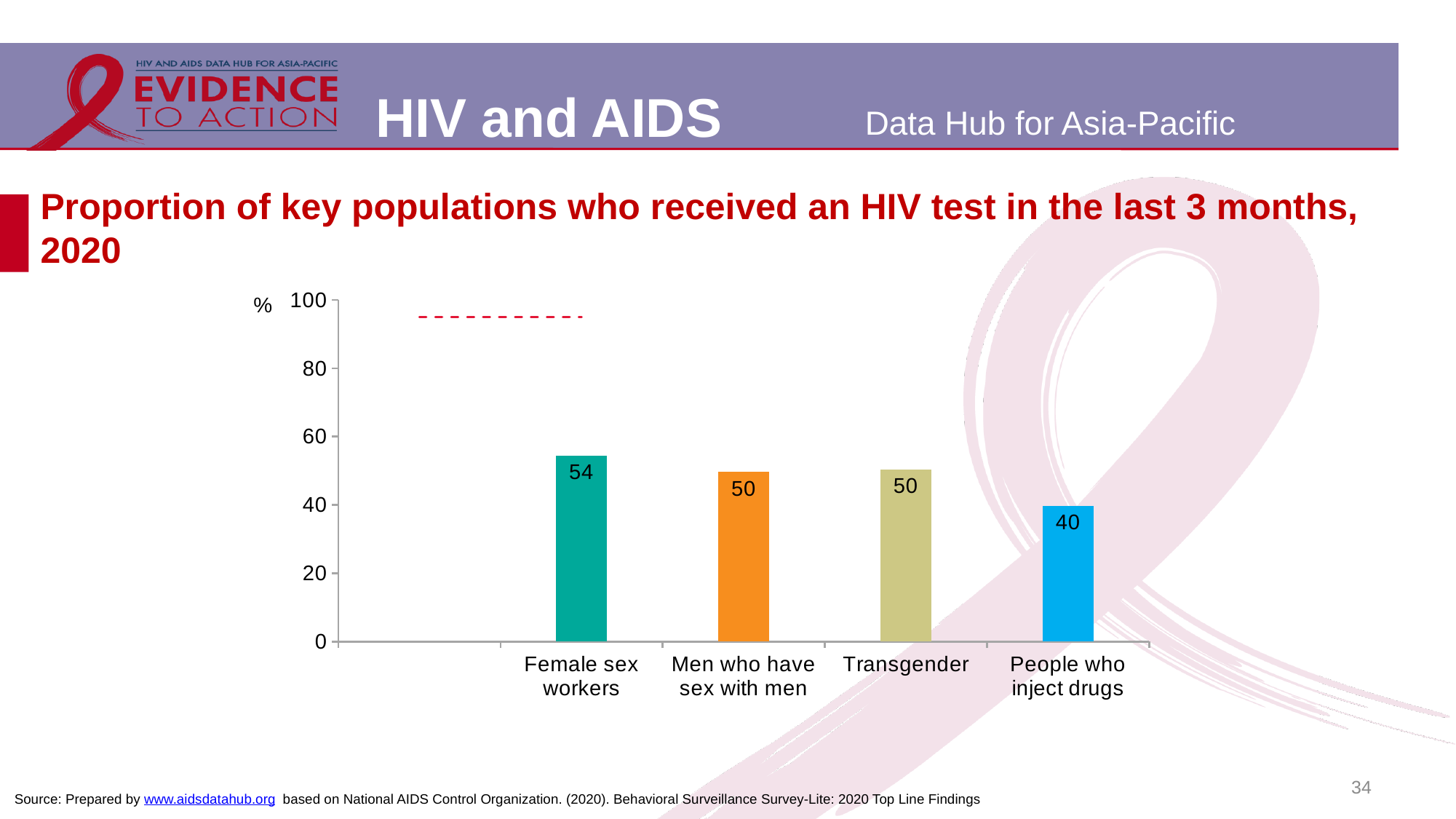
What is the value for Transgender? 50 Which is larger, the value for Female sex workers or the value for Men who have sex with men? Female sex workers Do the values rise or fall from Female sex workers to People who inject drugs along the x axis? fall What is the value for People who inject drugs? 40 What is the difference between the values for Female sex workers and People who inject drugs? 14 What is the value for Female sex workers? 54 What kind of chart is shown on the slide? bar chart Which category has the highest value? Female sex workers What unit is shown on the y axis of the chart? % Which category has the lowest value? People who inject drugs How many categories are shown on the x axis? 4 Is the value for People who inject drugs greater or less than 60? less